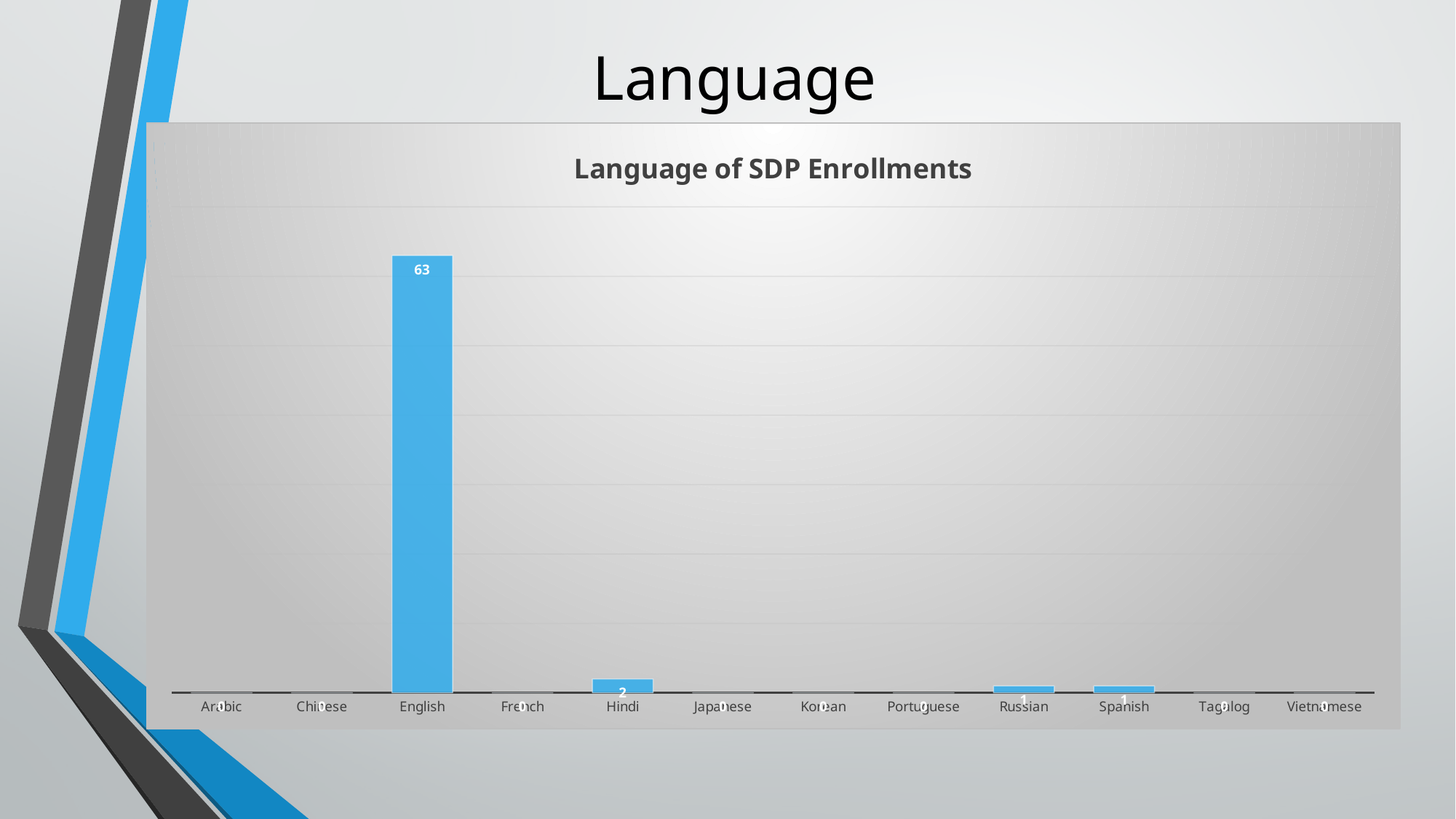
Which language has the highest number of SDP enrollments? English What is the difference between the values for English and Spanish? 62 Which has a larger value, Hindi or Russian? Hindi What is the title of the chart on the slide? Language of SDP Enrollments Which has a larger value, English or Hindi? English What is the value for English in the Language of SDP Enrollments chart? 63 What is the difference between the values for English and Hindi? 61 How many language categories are shown on the x axis of the chart? 12 What is the value for Russian in the Language of SDP Enrollments chart? 1 What is the value for Spanish in the Language of SDP Enrollments chart? 1 What is the value for Hindi in the Language of SDP Enrollments chart? 2 What kind of chart is shown on the slide? Bar chart